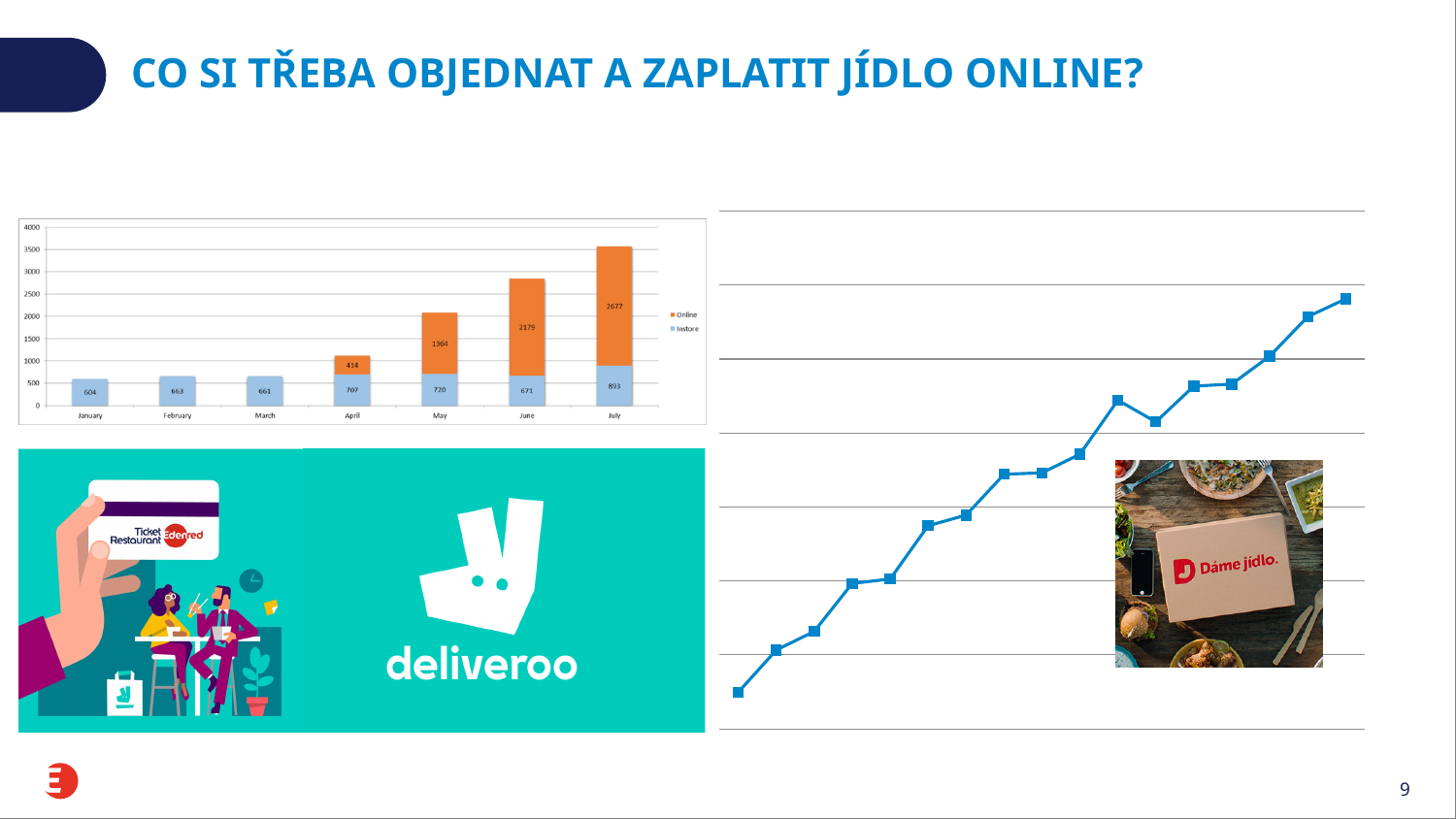
In the stacked bar chart on the left, how many series does the legend list? 2 In the stacked bar chart on the left, what is the difference between the Online values for July and June? 498 In the stacked bar chart on the left, what is the total of the July bar (Instore plus Online)? 3570 In the stacked bar chart on the left, which month has the lowest Instore value? January What kind of chart is shown on the right side of the slide, and do its values rise or fall from left to right? Line chart; rise In the stacked bar chart on the left, what is the Online value for May? 1364 In the stacked bar chart on the left, what is the Instore value for June? 671 In the stacked bar chart on the left, what is the Online value for July? 2677 In the stacked bar chart on the left, which month has the highest Instore value? July In the stacked bar chart on the left, how many months are shown on the x axis? 7 In the stacked bar chart on the left, what is the Instore value for January? 604 In the stacked bar chart on the left, which is larger in June: the Online value or the Instore value? Online